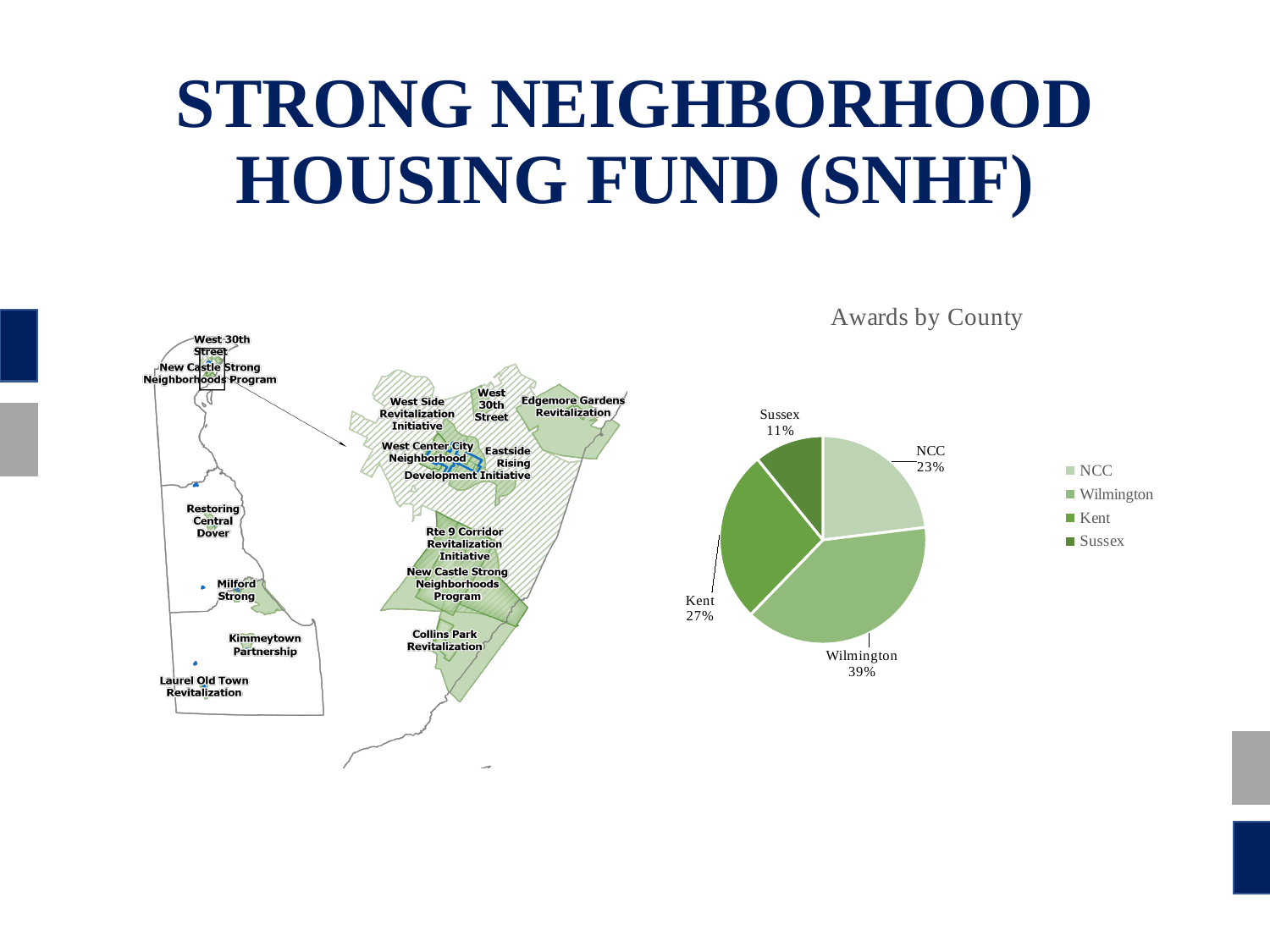
How many entries does the legend of the 'Awards by County' chart list? 4 What share of awards does Kent have in the 'Awards by County' chart? 27% In the 'Awards by County' chart, which has a larger share, NCC or Kent? Kent In the 'Awards by County' chart, what is the difference between Wilmington's share and Kent's share? 12% Which county has the smallest share in the 'Awards by County' chart? Sussex What share of awards does NCC have in the 'Awards by County' chart? 23% What share of awards does Sussex have in the 'Awards by County' chart? 11% Which county has the largest share in the 'Awards by County' chart? Wilmington How many slices does the 'Awards by County' pie chart have? 4 What share of awards does Wilmington have in the 'Awards by County' chart? 39% What kind of chart is the 'Awards by County' chart? pie chart What is the title of the pie chart on the slide? Awards by County